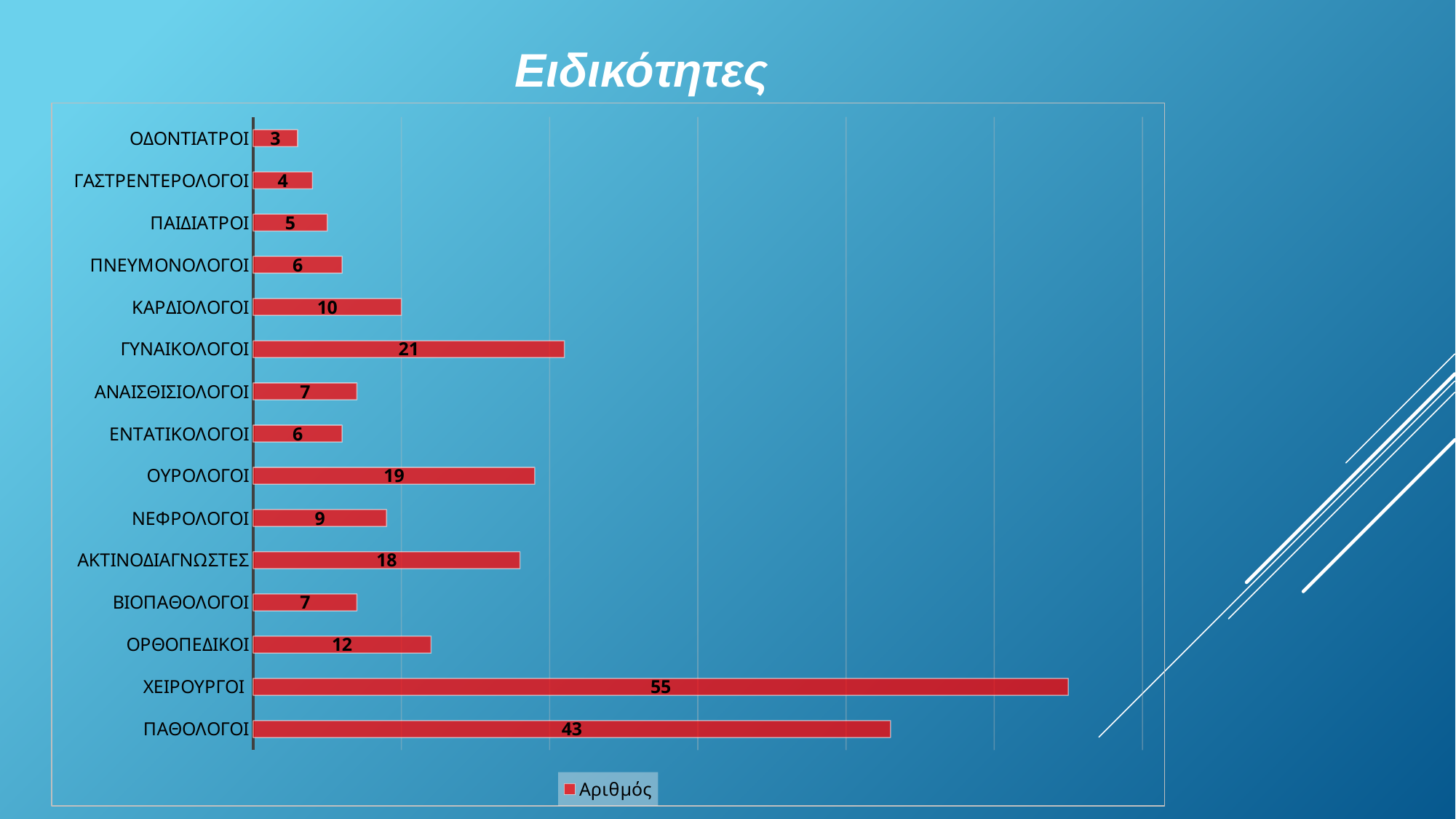
What is the value for ΧΕΙΡΟΥΡΓΟΙ? 55 How many series does the legend list? 1 Which is larger, the value for ΚΑΡΔΙΟΛΟΓΟΙ or the value for ΟΡΘΟΠΕΔΙΚΟΙ? ΟΡΘΟΠΕΔΙΚΟΙ What is the value for ΓΥΝΑΙΚΟΛΟΓΟΙ? 21 What kind of chart is shown on the slide? Bar chart How many categories are shown in the chart? 15 What is the title of the chart? Ειδικότητες What is the difference between the values for ΟΥΡΟΛΟΓΟΙ and ΝΕΦΡΟΛΟΓΟΙ? 10 Which category has the highest value? ΧΕΙΡΟΥΡΓΟΙ Which category has the lowest value? ΟΔΟΝΤΙΑΤΡΟΙ What is the value for ΑΚΤΙΝΟΔΙΑΓΝΩΣΤΕΣ? 18 What is the difference between the values for ΧΕΙΡΟΥΡΓΟΙ and ΠΑΘΟΛΟΓΟΙ? 12